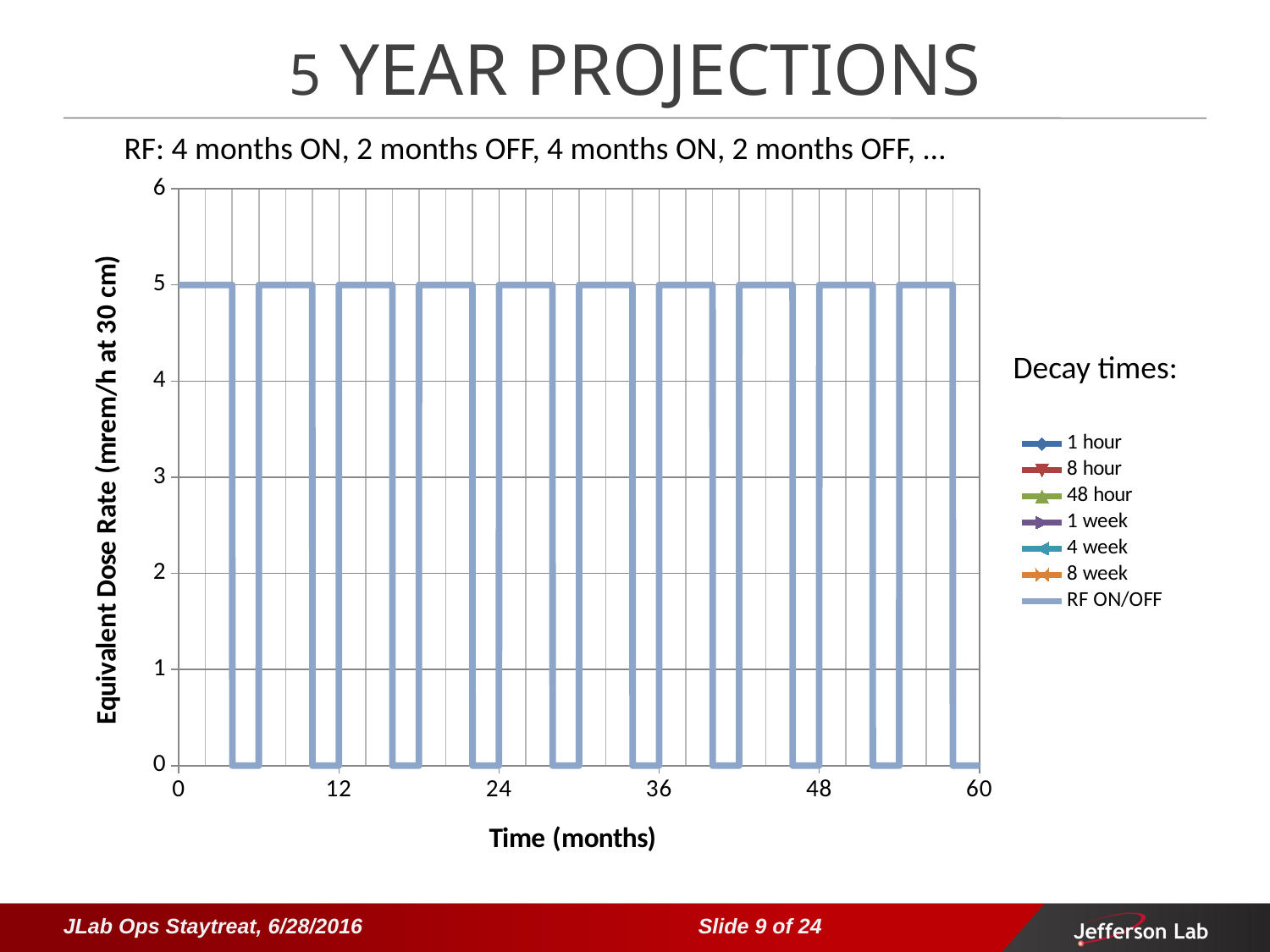
Is the RF ON/OFF value at 5 months greater or less than 1? less What is the difference between the RF ON level and the RF OFF level of the RF ON/OFF series? 5 What value does the RF ON/OFF series reach when RF is ON? 5 What is the highest value shown on the x axis? 60 How many series does the chart legend list? 7 What kind of chart is shown on the slide? line chart What is the highest value shown on the y axis? 6 Is the RF ON/OFF value at 2 months greater or less than 4? greater How many RF ON periods are plotted over the 60 months? 10 What value does the RF ON/OFF series drop to when RF is OFF? 0 What is the label of the y axis? Equivalent Dose Rate (mrem/h at 30 cm) What is the label of the x axis? Time (months)